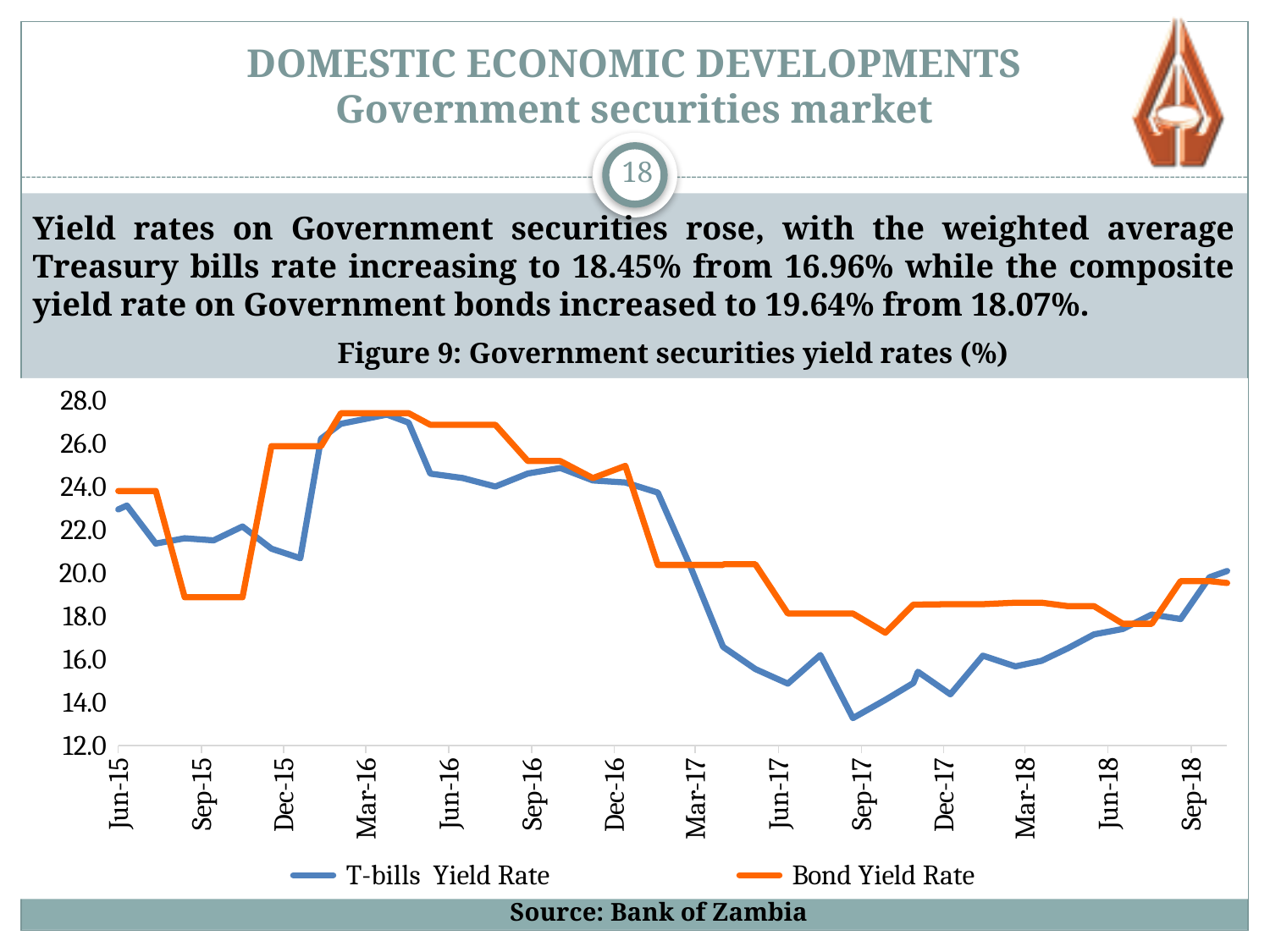
Does the T-bills Yield Rate rise or fall between Dec-16 and Sep-17? fall What kind of chart is shown in Figure 9? line chart At Sep-15, which series is higher, the T-bills Yield Rate or the Bond Yield Rate? T-bills Yield Rate At Sep-17, which series is higher, the T-bills Yield Rate or the Bond Yield Rate? Bond Yield Rate Is the Bond Yield Rate at Sep-15 greater or less than 20.0? less What are the two series named in the chart legend? T-bills Yield Rate and Bond Yield Rate What source is cited below the chart? Bank of Zambia How many series does the legend of the chart list? 2 Is the T-bills Yield Rate at Jun-17 greater or less than 16.0? less How many date labels are shown along the x axis of the chart? 14 Is the Bond Yield Rate at Mar-16 greater or less than 26.0? greater